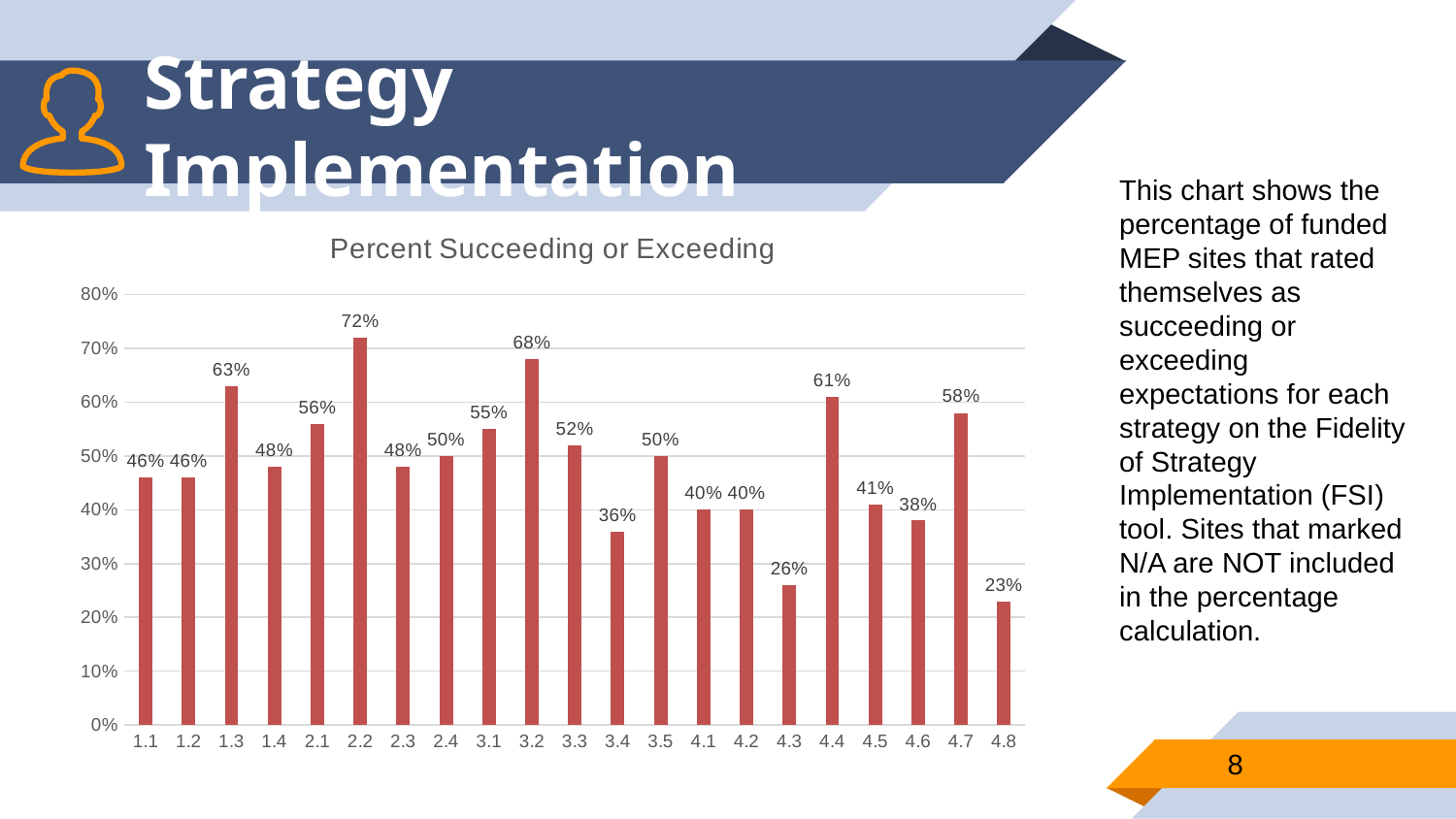
What is the value for strategy 4.5? 41% What is the value for strategy 2.2? 72% How many strategies are shown on the x axis? 21 What is the difference between the values for strategy 2.2 and strategy 4.8? 49% What is the title of the chart? Percent Succeeding or Exceeding What is the difference between the values for strategy 1.3 and strategy 3.4? 27% What is the value for strategy 3.2? 68% Which strategy has the highest percent succeeding or exceeding? 2.2 What is the value for strategy 4.3? 26% Which has a larger value, strategy 4.4 or strategy 4.7? 4.4 Which strategy has the lowest percent succeeding or exceeding? 4.8 What kind of chart is shown on the slide? Bar chart